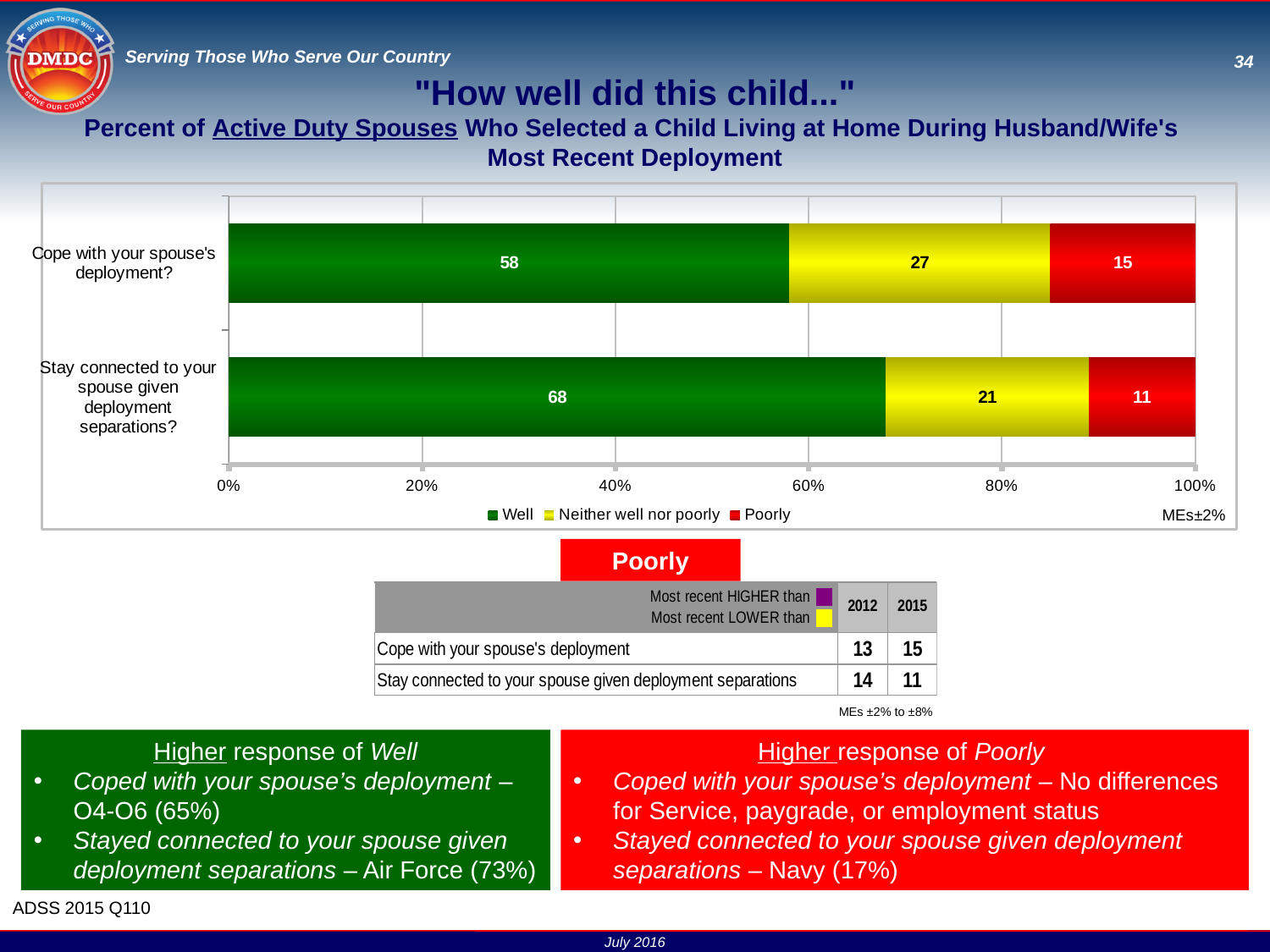
What kind of chart is shown on the slide? Stacked bar chart What is the "Neither well nor poorly" value for "Cope with your spouse's deployment?" 27 What is the "Poorly" value for "Stay connected to your spouse given deployment separations?" 11 Which category has the higher "Well" value? Stay connected to your spouse given deployment separations? Which category has the lower "Poorly" value? Stay connected to your spouse given deployment separations? Is the "Poorly" value larger for "Cope with your spouse's deployment?" or for "Stay connected to your spouse given deployment separations?" Cope with your spouse's deployment? How many series does the legend list? 3 What is the total of the stacked bar for "Cope with your spouse's deployment?" 100 Which colour represents the "Poorly" series in the chart? Red How many categories are shown on the chart? 2 What percent of active duty spouses said their child coped "Well" with the spouse's deployment? 58 What is the difference between the "Well" values for the two categories? 10